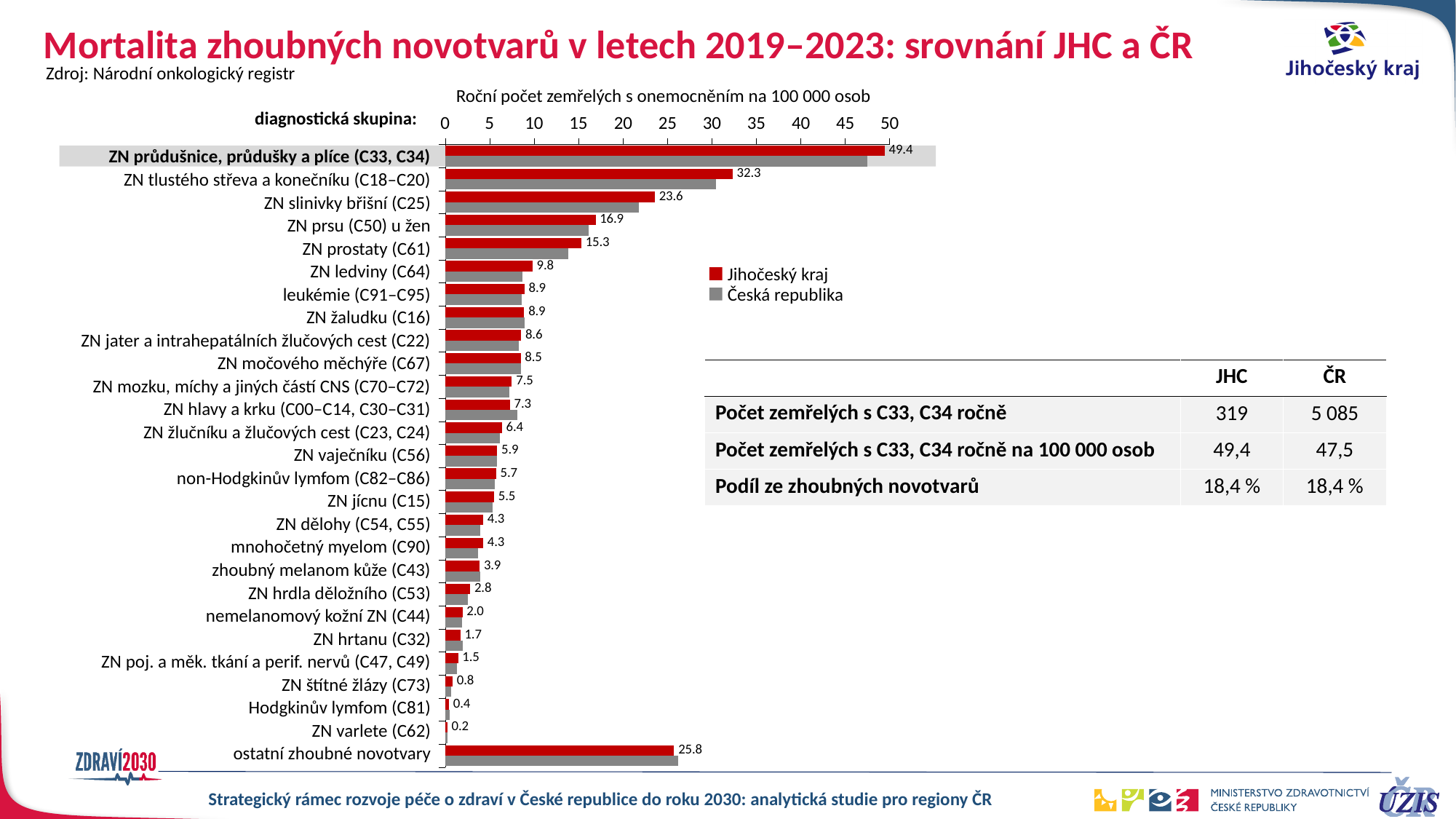
How many diagnostic groups (categories) are plotted on the chart? 27 How many series does the chart legend list? 2 What kind of chart is shown on the slide? bar chart What is the value for Jihočeský kraj for ostatní zhoubné novotvary? 25.8 What is the value for Jihočeský kraj for ZN slinivky břišní (C25)? 23.6 Which diagnostic group has the highest value for Jihočeský kraj? ZN průdušnice, průdušky a plíce (C33, C34) Which colour represents Jihočeský kraj in the chart? red What is the value for Jihočeský kraj for ZN prostaty (C61)? 15.3 What is the difference between the Jihočeský kraj values for ZN průdušnice, průdušky a plíce (C33, C34) and ZN tlustého střeva a konečníku (C18–C20)? 17.1 Is the Česká republika value for ZN slinivky břišní (C25) greater or less than 20? greater What is the value for Jihočeský kraj for ZN průdušnice, průdušky a plíce (C33, C34)? 49.4 Which diagnostic group has the lowest value for Jihočeský kraj? ZN varlete (C62)